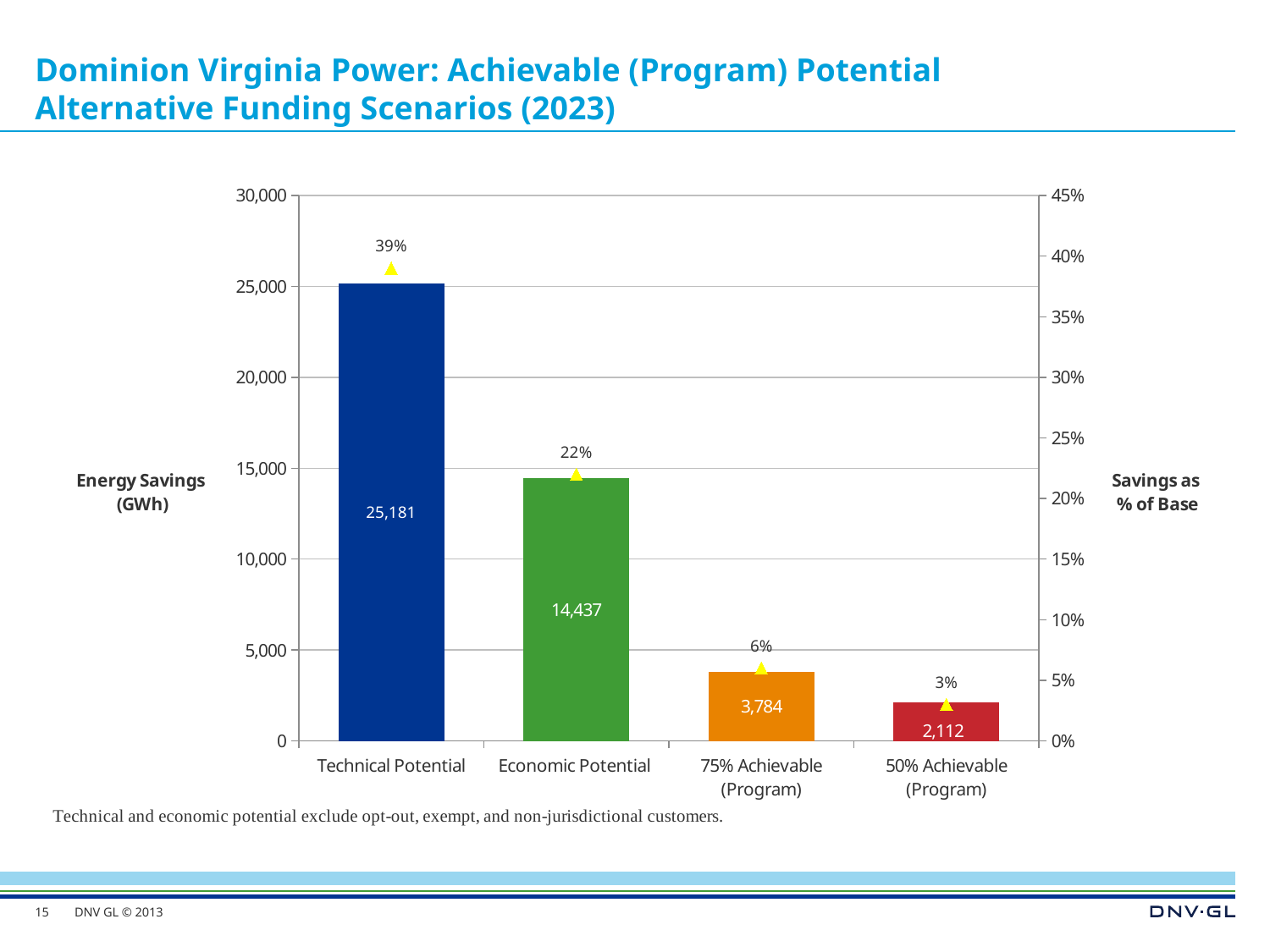
Which has a larger energy savings (GWh) value, Economic Potential or 75% Achievable (Program)? Economic Potential Which category has the highest energy savings (GWh)? Technical Potential What is the energy savings (GWh) value for 50% Achievable (Program)? 2,112 How many categories are shown on the x axis? 4 What is the difference in energy savings (GWh) between 75% Achievable (Program) and 50% Achievable (Program)? 1,672 What kind of chart is used to show the energy savings (GWh) values? Bar chart What is the energy savings (GWh) value for Technical Potential? 25,181 What is the difference in energy savings (GWh) between Technical Potential and Economic Potential? 10,744 What is the energy savings (GWh) value for Economic Potential? 14,437 What is the savings as % of base for Technical Potential? 39% What is the savings as % of base for 75% Achievable (Program)? 6% Which category has the lowest savings as % of base? 50% Achievable (Program)